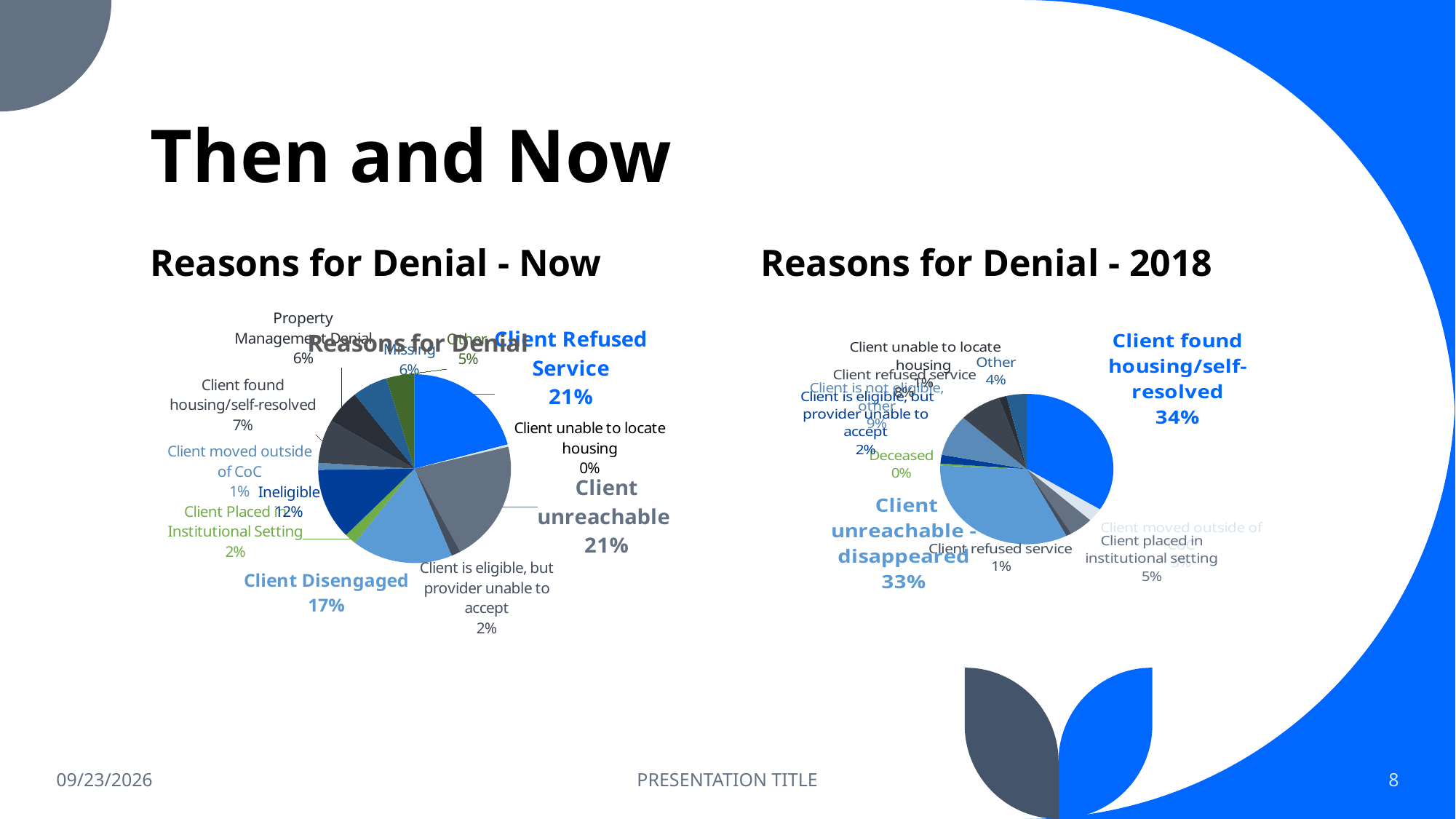
In the 'Reasons for Denial - Now' chart, what share is Client Refused Service? 21% In the 'Reasons for Denial - Now' chart, what share is Client Disengaged? 17% In the 'Reasons for Denial - Now' chart, what share is Client found housing/self-resolved? 7% In the 'Reasons for Denial - 2018' chart, what share is Other? 4% In the 'Reasons for Denial - Now' chart, what is the difference in percentage points between Client Disengaged and Ineligible? 5 percentage points In the 'Reasons for Denial - 2018' chart, what share is Client placed in institutional setting? 5% In the 'Reasons for Denial - Now' chart, what share is Property Management Denial? 6% In the 'Reasons for Denial - 2018' chart, what share is Client unreachable - disappeared? 33% What type of chart is used for 'Reasons for Denial - 2018'? Pie chart In the 'Reasons for Denial - Now' chart, which is larger, Client Disengaged or Ineligible? Client Disengaged In the 'Reasons for Denial - Now' chart, what share is Ineligible? 12% In the 'Reasons for Denial - 2018' chart, what share is Client found housing/self-resolved? 34%